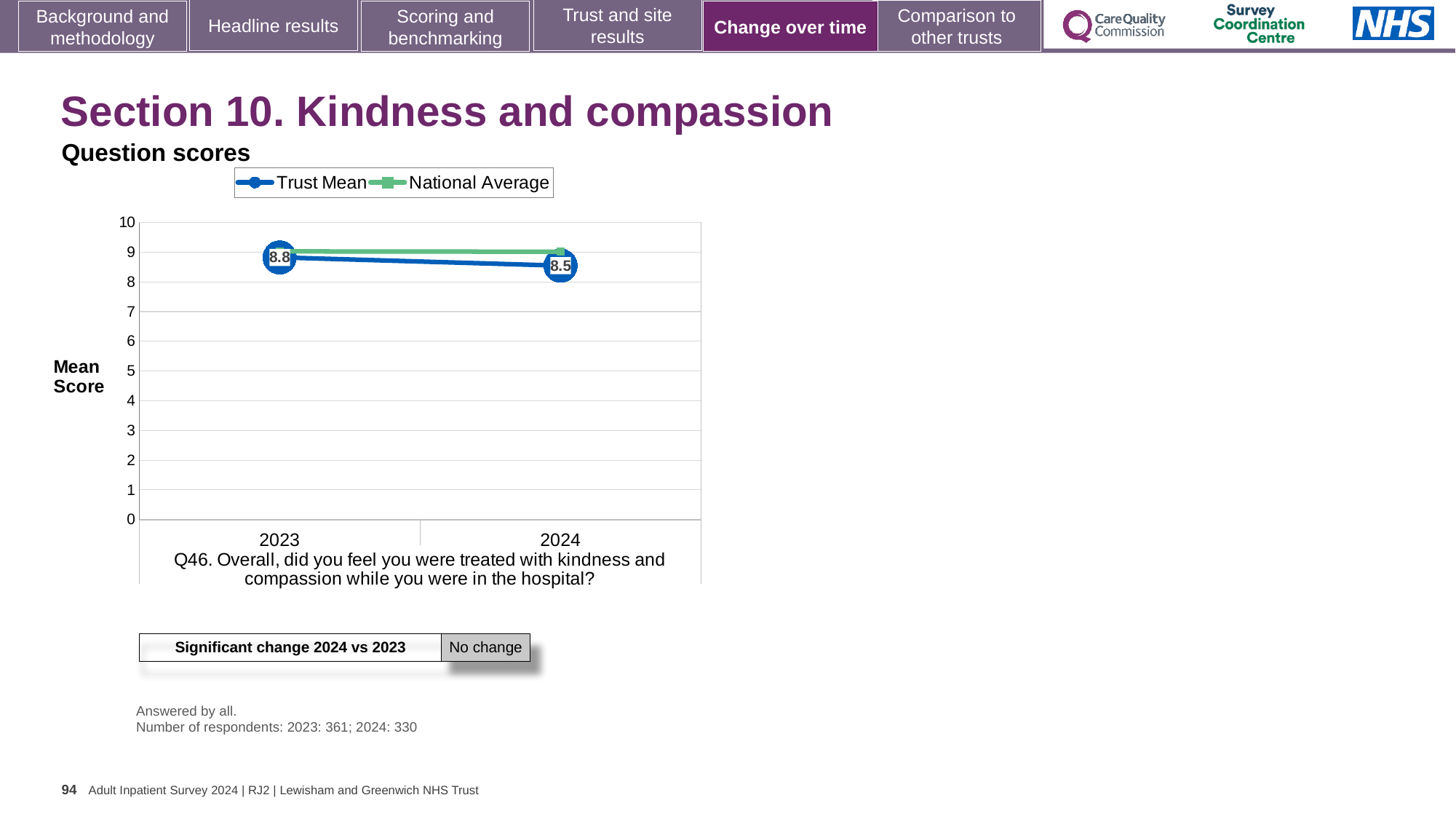
By how much did the Trust Mean score change from 2023 to 2024? 0.3 What kind of chart is shown on the slide? line chart What is the Trust Mean score for 2023? 8.8 What are the two series named in the legend? Trust Mean and National Average Does the Trust Mean line rise or fall from 2023 to 2024? fall Is the National Average value for 2024 greater or less than 8? greater How many series does the legend list? 2 Which year has the higher Trust Mean score, 2023 or 2024? 2023 What is the label on the y axis of the chart? Mean Score How many years are plotted on the x axis? 2 In 2024, which is higher, the Trust Mean or the National Average? National Average What is the Trust Mean score for 2024? 8.5